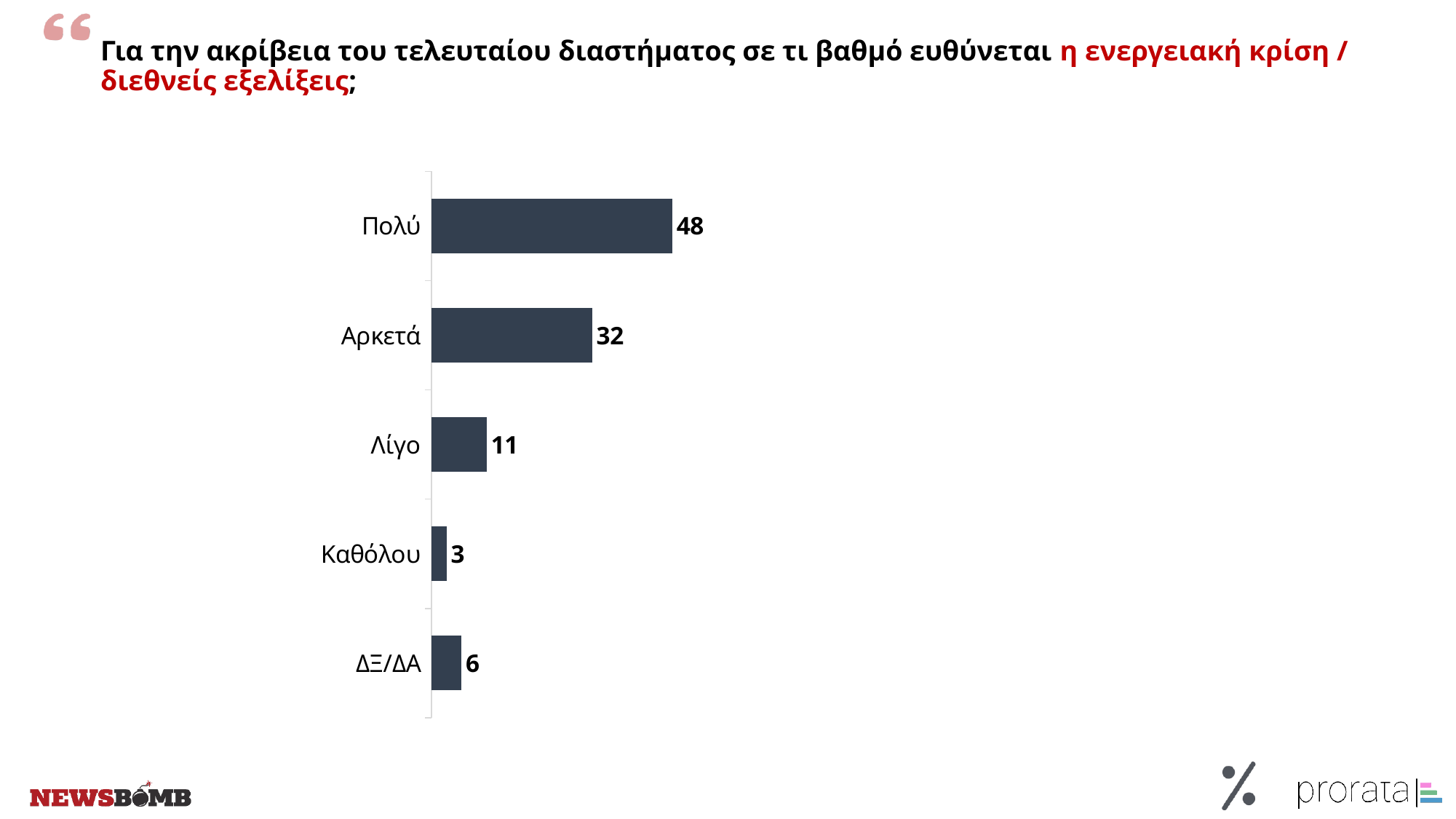
Which is larger, the value for Λίγο or the value for ΔΞ/ΔΑ? Λίγο What is the value for ΔΞ/ΔΑ? 6 What is the difference between the values for Πολύ and Αρκετά? 16 Which category has the lowest value? Καθόλου What is the value for Πολύ? 48 What kind of chart is shown on the slide? Bar chart Which category has the highest value? Πολύ What is the combined value of Πολύ and Αρκετά? 80 What is the value for Καθόλου? 3 What is the value for Αρκετά? 32 What is the value for Λίγο? 11 How many categories are shown in the chart? 5